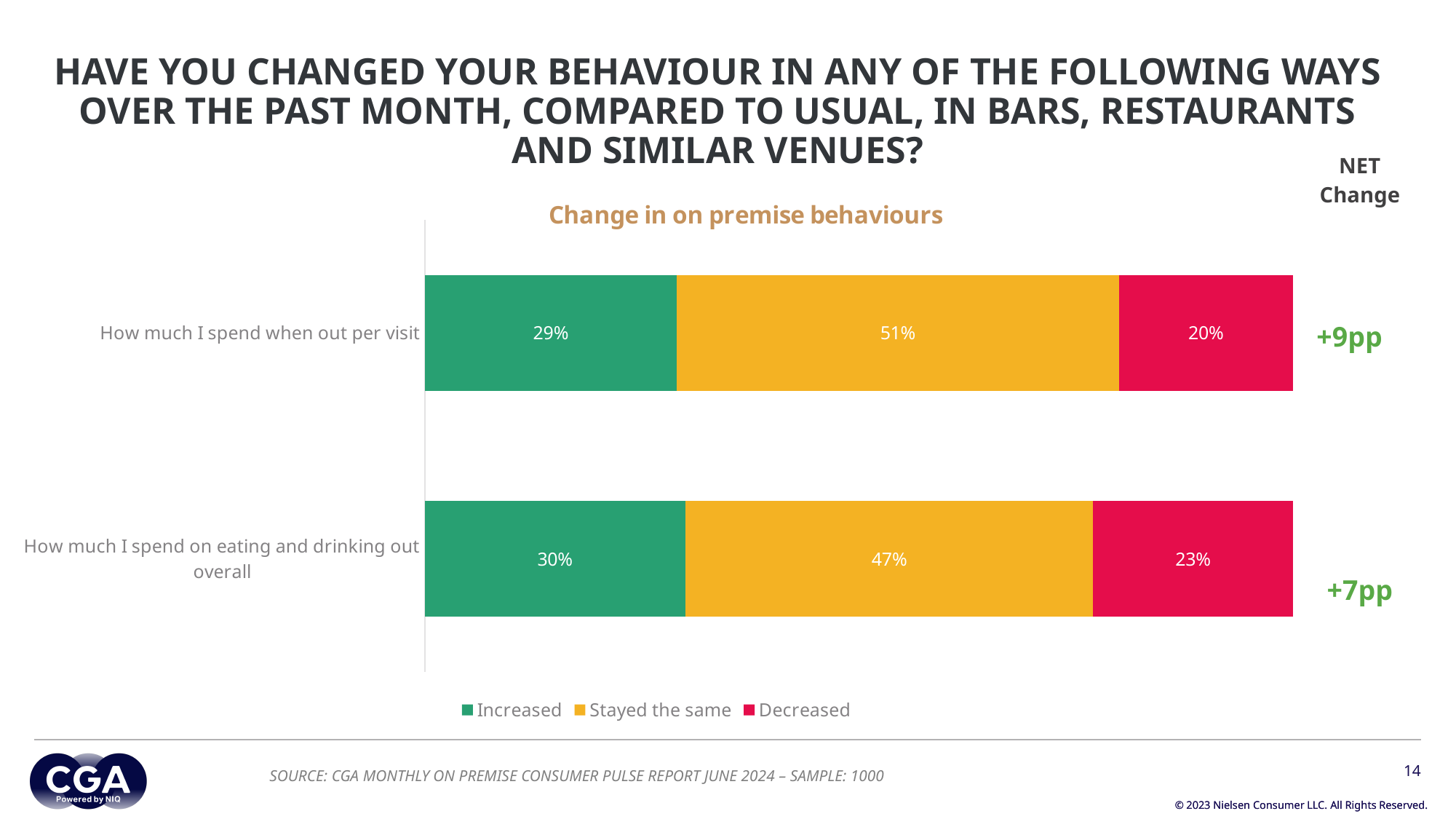
How many behaviour categories are shown on the chart? 2 What percentage of respondents said they increased how much they spend when out per visit? 29% Which is larger: the 'Decreased' share for spend per visit or for spend on eating and drinking out overall? Spend on eating and drinking out overall What percentage said they decreased how much they spend on eating and drinking out overall? 23% Which response category has the smallest share for 'How much I spend on eating and drinking out overall'? Decreased What is the difference between the 'Stayed the same' shares for spend per visit and spend on eating and drinking out overall? 4 percentage points What is the NET Change shown for 'How much I spend when out per visit'? +9pp What type of chart is shown on the slide? Stacked bar chart Which response category has the largest share for 'How much I spend when out per visit'? Stayed the same What percentage said they decreased how much they spend when out per visit? 20% What percentage said their spend on eating and drinking out overall stayed the same? 47% How many series does the legend list? 3